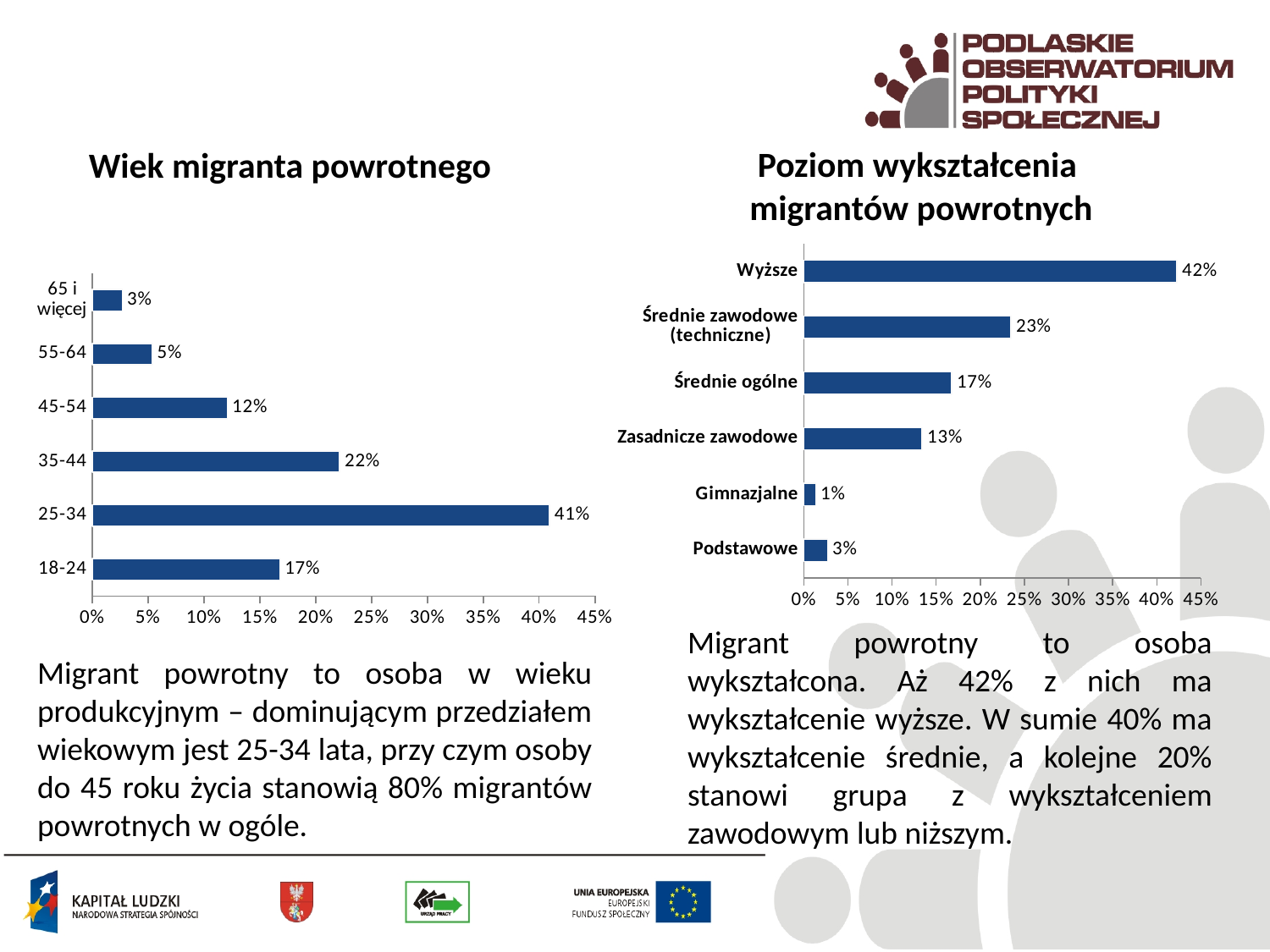
In the 'Poziom wykształcenia migrantów powrotnych' chart, what is the difference between Średnie zawodowe (techniczne) and Średnie ogólne? 6% In the 'Poziom wykształcenia migrantów powrotnych' chart, what is the value for Wyższe? 42% In the 'Poziom wykształcenia migrantów powrotnych' chart, how many education categories are shown? 6 In the 'Wiek migranta powrotnego' chart, which age group has the lowest value? 65 i więcej What type of chart is the 'Poziom wykształcenia migrantów powrotnych' chart? Bar chart In the 'Wiek migranta powrotnego' chart, what is the value for the 25-34 age group? 41% In the 'Wiek migranta powrotnego' chart, which is larger, the value for 45-54 or for 55-64? 45-54 In the 'Poziom wykształcenia migrantów powrotnych' chart, which category has the lowest value? Gimnazjalne In the 'Wiek migranta powrotnego' chart, what is the difference between the values for 25-34 and 35-44? 19% In the 'Poziom wykształcenia migrantów powrotnych' chart, what is the value for Zasadnicze zawodowe? 13% In the 'Wiek migranta powrotnego' chart, what is the value for the 18-24 age group? 17% In the 'Wiek migranta powrotnego' chart, how many age categories are shown? 6